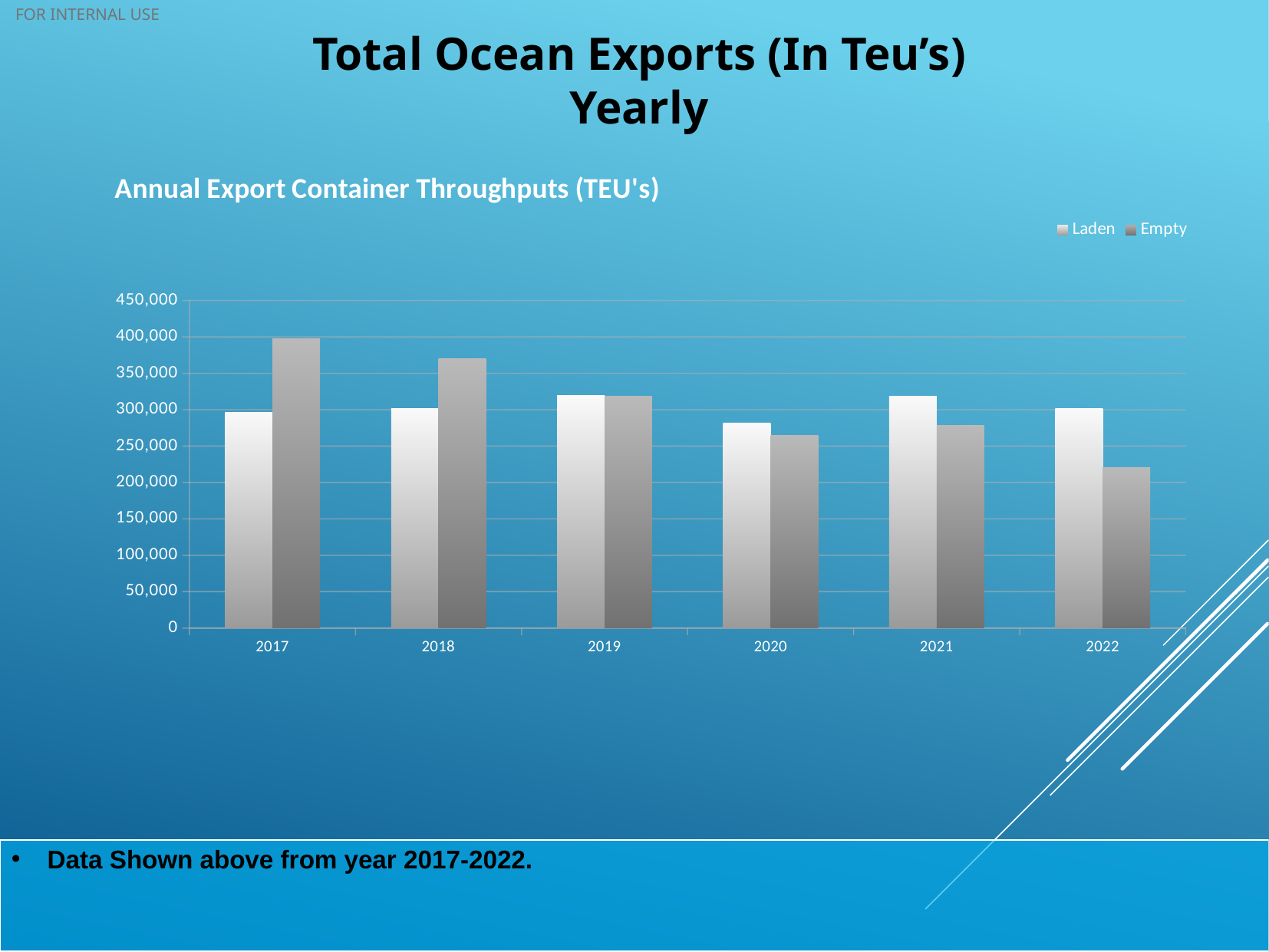
What is the title of the chart? Annual Export Container Throughputs (TEU's) How many series does the chart legend list? 2 In which year is the Empty value highest? 2017 In 2022, which is larger, the Laden value or the Empty value? Laden What are the two series named in the chart legend? Laden and Empty Is the Empty value for 2017 greater or less than 350,000? greater What kind of chart is shown on the slide? bar chart How many years are shown on the x axis of the chart? 6 Is the Laden value for 2020 greater or less than 300,000? less Is the Empty value for 2022 greater or less than 250,000? less In which year is the Laden value lowest? 2020 In which year is the Empty value lowest? 2022